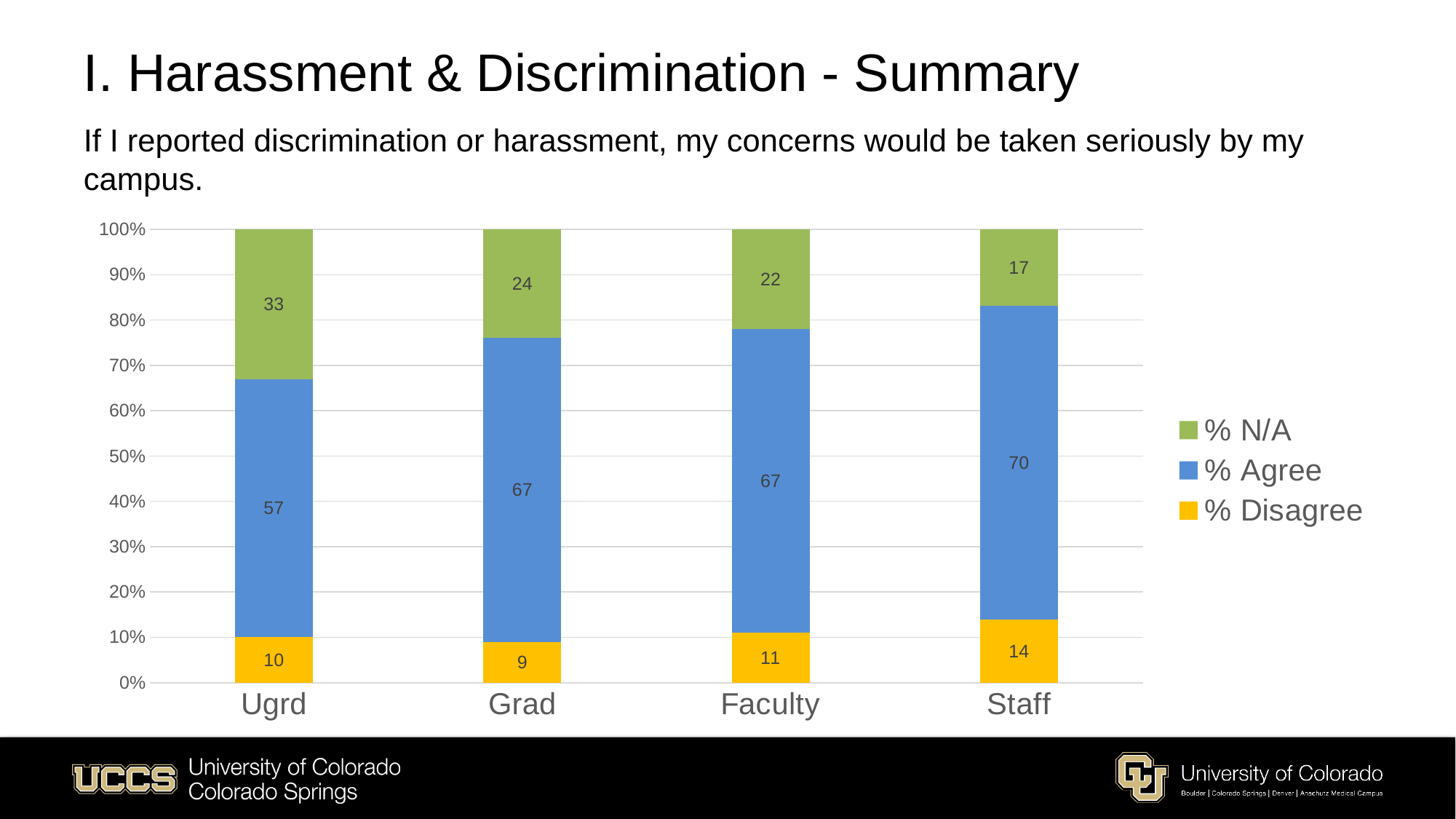
Which colour represents % Disagree in the chart? Yellow How many series does the legend list? 3 What is the % Agree value for Staff? 70 Which category has the lowest % N/A value? Staff What is the difference between the % Disagree values for Staff and Grad? 5 How many categories are shown on the x axis? 4 Which category has the lowest % Disagree value? Grad What is the % N/A value for Ugrd? 33 Which category has the highest % Agree value? Staff What is the % Disagree value for Grad? 9 Which is larger, the % N/A value for Grad or for Faculty? Grad What kind of chart is shown on the slide? Stacked bar chart